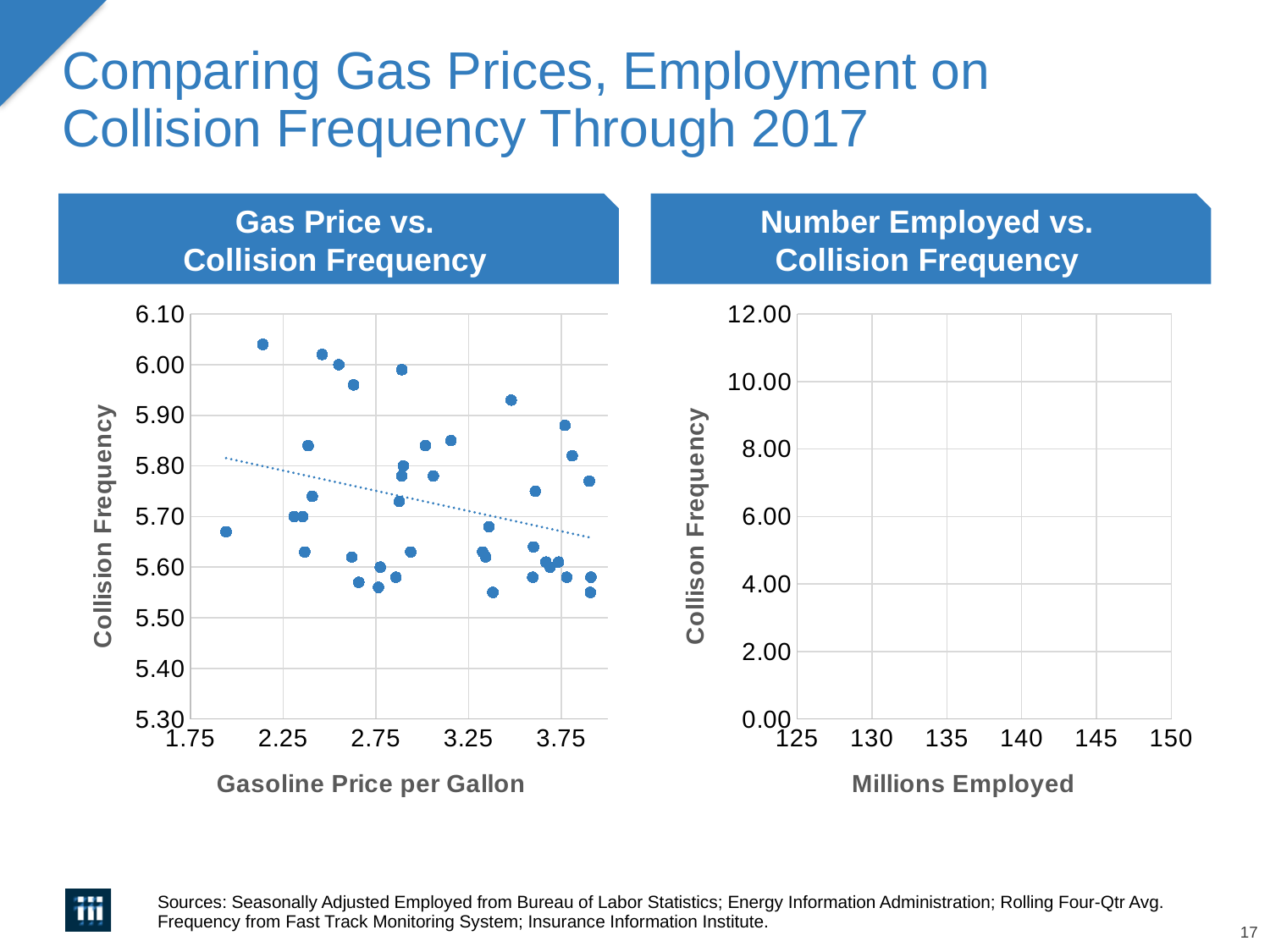
On the 'Gas Price vs. Collision Frequency' chart, are there any points with a collision frequency greater than 6.10? No What is the x-axis title of the 'Gas Price vs. Collision Frequency' chart? Gasoline Price per Gallon On the 'Gas Price vs. Collision Frequency' chart, is the collision frequency of the highest point greater or less than 6.00? greater What is the x-axis title of the 'Number Employed vs. Collision Frequency' chart? Millions Employed On the 'Gas Price vs. Collision Frequency' chart, does the dotted trend line rise or fall as gasoline price increases? Fall On the 'Gas Price vs. Collision Frequency' chart, is the collision frequency of the leftmost point (near a gas price of 2.00) greater or less than 5.80? less What kind of chart is the 'Gas Price vs. Collision Frequency' chart? Scatter chart